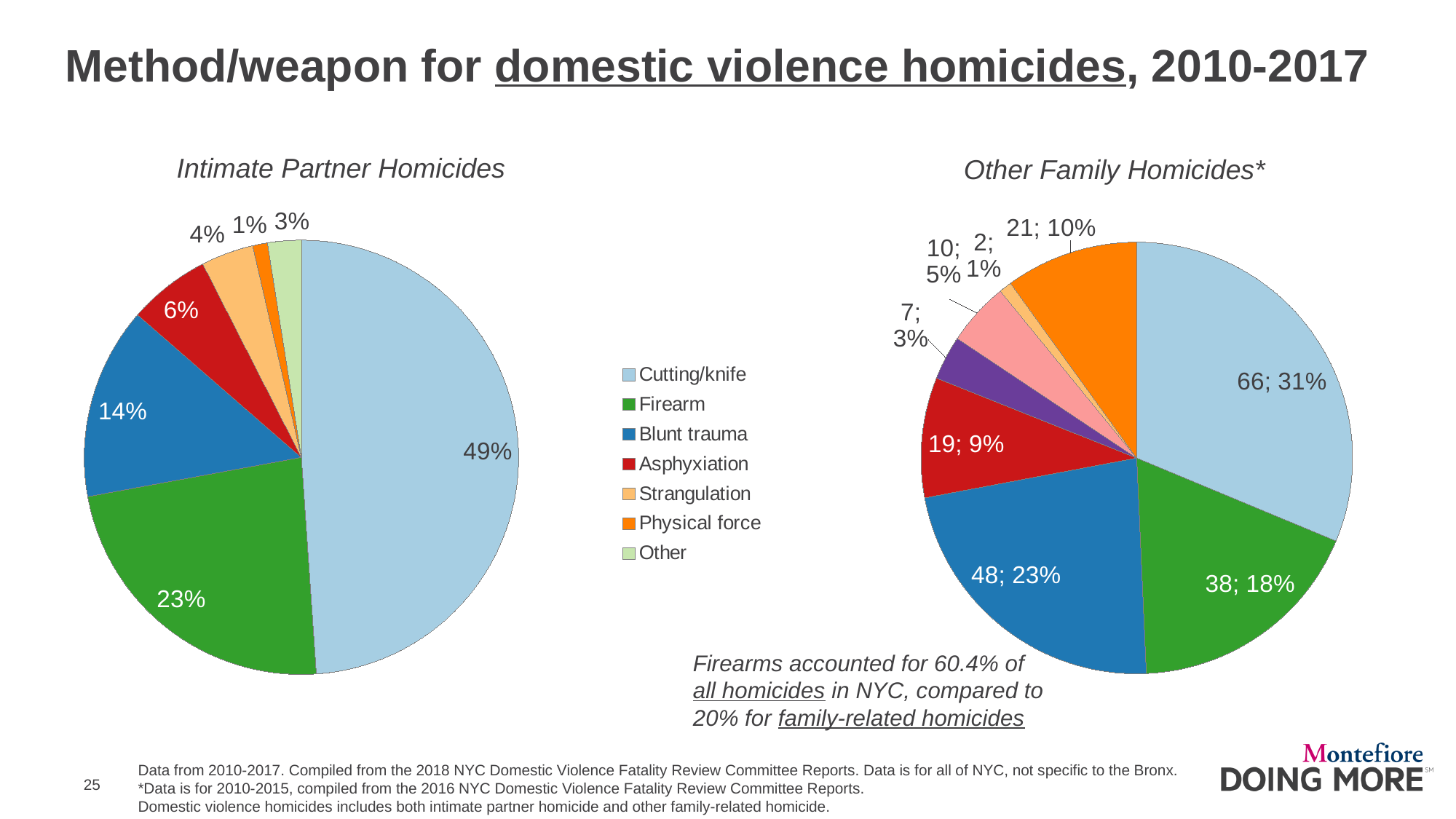
In the Intimate Partner Homicides pie chart, which method has the smallest share? Physical force In the Intimate Partner Homicides pie chart, which method has the largest share? Cutting/knife What type of chart is used for Intimate Partner Homicides? Pie chart In the Intimate Partner Homicides pie chart, what share is Cutting/knife? 49% In the Other Family Homicides pie chart, what is the count and share for Cutting/knife? 66; 31% How many entries does the legend list? 7 In the Intimate Partner Homicides pie chart, what share is Blunt trauma? 14% In the Other Family Homicides pie chart, what is the difference in count between Cutting/knife and Firearm? 28 In the Intimate Partner Homicides pie chart, what share is Firearm? 23% In the Other Family Homicides pie chart, what is the count for Blunt trauma? 48 In the Other Family Homicides pie chart, which is larger, Firearm or Blunt trauma? Blunt trauma